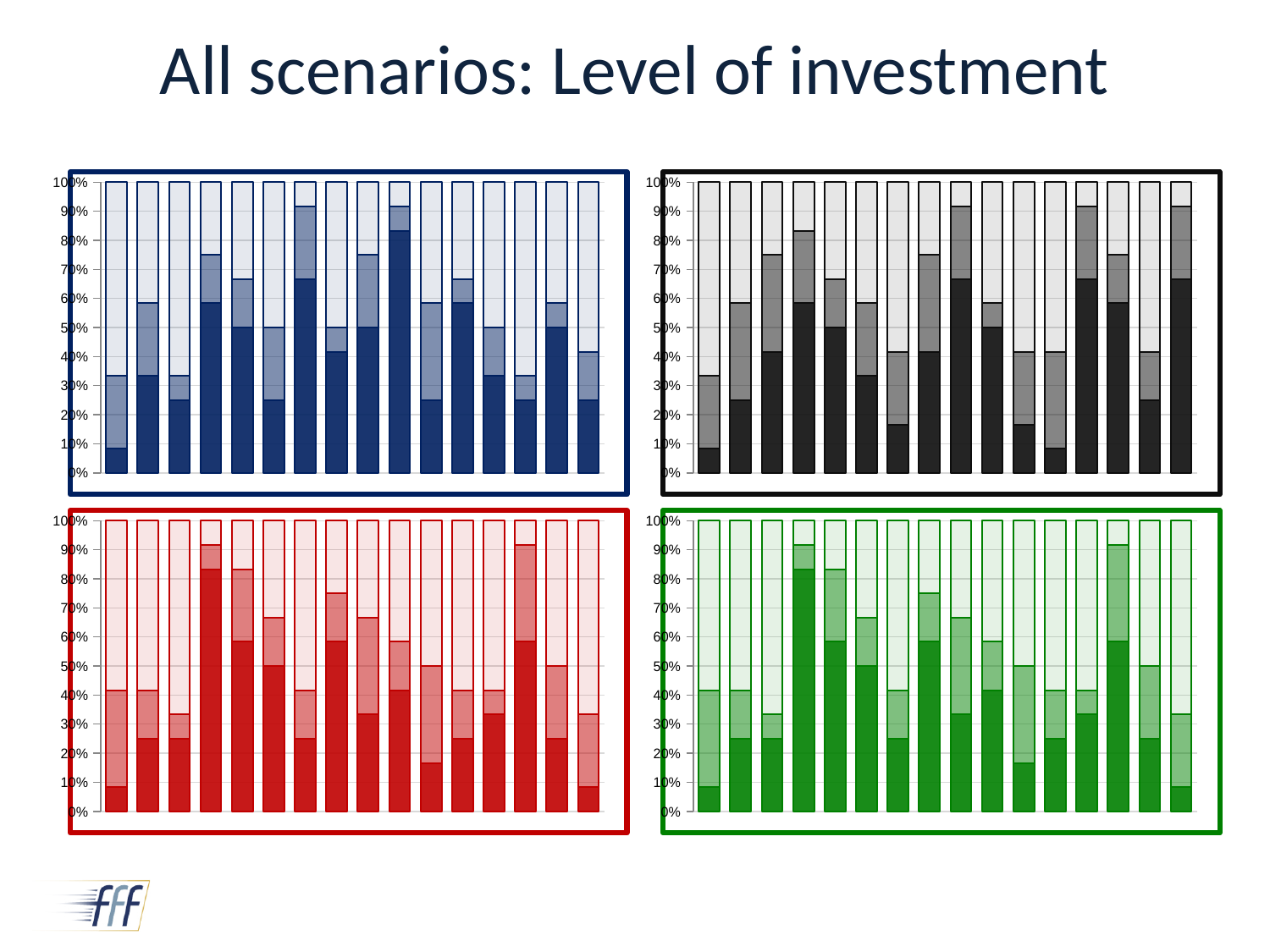
What kind of chart is the top-left chart on the slide? stacked bar chart How many bars does the top-left (blue) chart contain? 16 In the top-left (blue) chart, what is the highest value shown on the vertical axis? 100% How many bars does the bottom-right (green) chart contain? 16 In the top-right (black) chart, is the top of the black segment of the fourth bar from the left greater or less than 50%? greater How many charts are shown on the slide? 4 In the top-left (blue) chart, is the top of the dark blue segment of the tenth bar from the left greater or less than 70%? greater In the top-left (blue) chart, which bar has the tallest dark blue segment: the first bar from the left or the tenth bar from the left? the tenth bar In the bottom-right (green) chart, is the top of the dark green segment of the first bar from the left greater or less than 20%? less What is the title of the slide? All scenarios: Level of investment